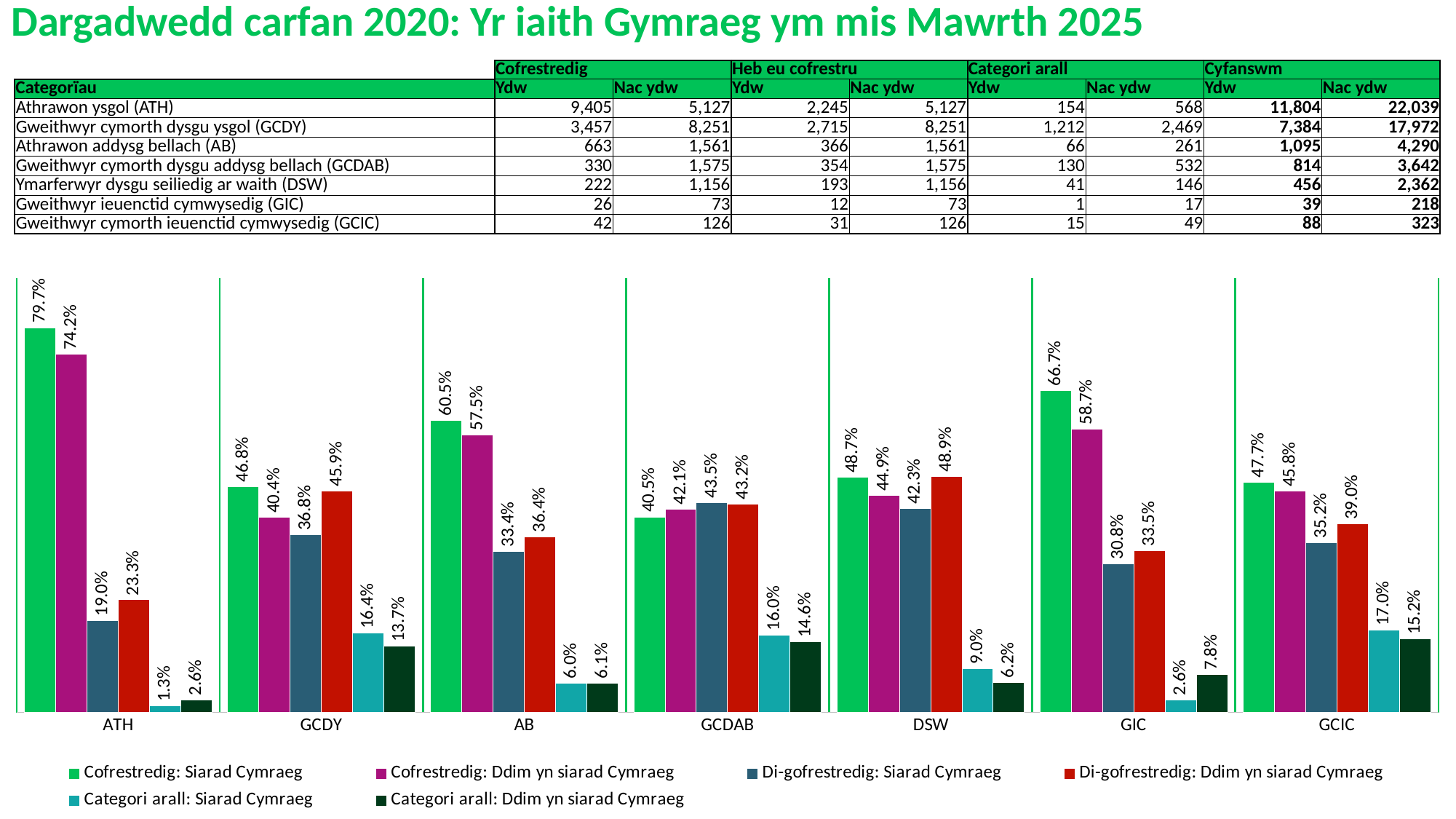
Does the value for 'Cofrestredig: Siarad Cymraeg' rise or fall from ATH to GCDY? fall What is the value for 'Categori arall: Siarad Cymraeg' in the GCIC category? 17.0% In the AB category, which is larger: 'Cofrestredig: Siarad Cymraeg' or 'Di-gofrestredig: Siarad Cymraeg'? Cofrestredig: Siarad Cymraeg What type of chart is shown on the slide? bar chart What is the value for 'Cofrestredig: Siarad Cymraeg' in the ATH category? 79.7% What is the value for 'Di-gofrestredig: Ddim yn siarad Cymraeg' in the GCDY category? 45.9% How many categories are shown along the x axis of the chart? 7 Which colour represents 'Di-gofrestredig: Ddim yn siarad Cymraeg' in the chart legend? red How many series does the chart legend list? 6 Which category has the highest value for 'Cofrestredig: Siarad Cymraeg'? ATH What is the difference between 'Cofrestredig: Siarad Cymraeg' and 'Cofrestredig: Ddim yn siarad Cymraeg' in the GIC category? 8.0% Which category has the lowest value for 'Categori arall: Siarad Cymraeg'? ATH